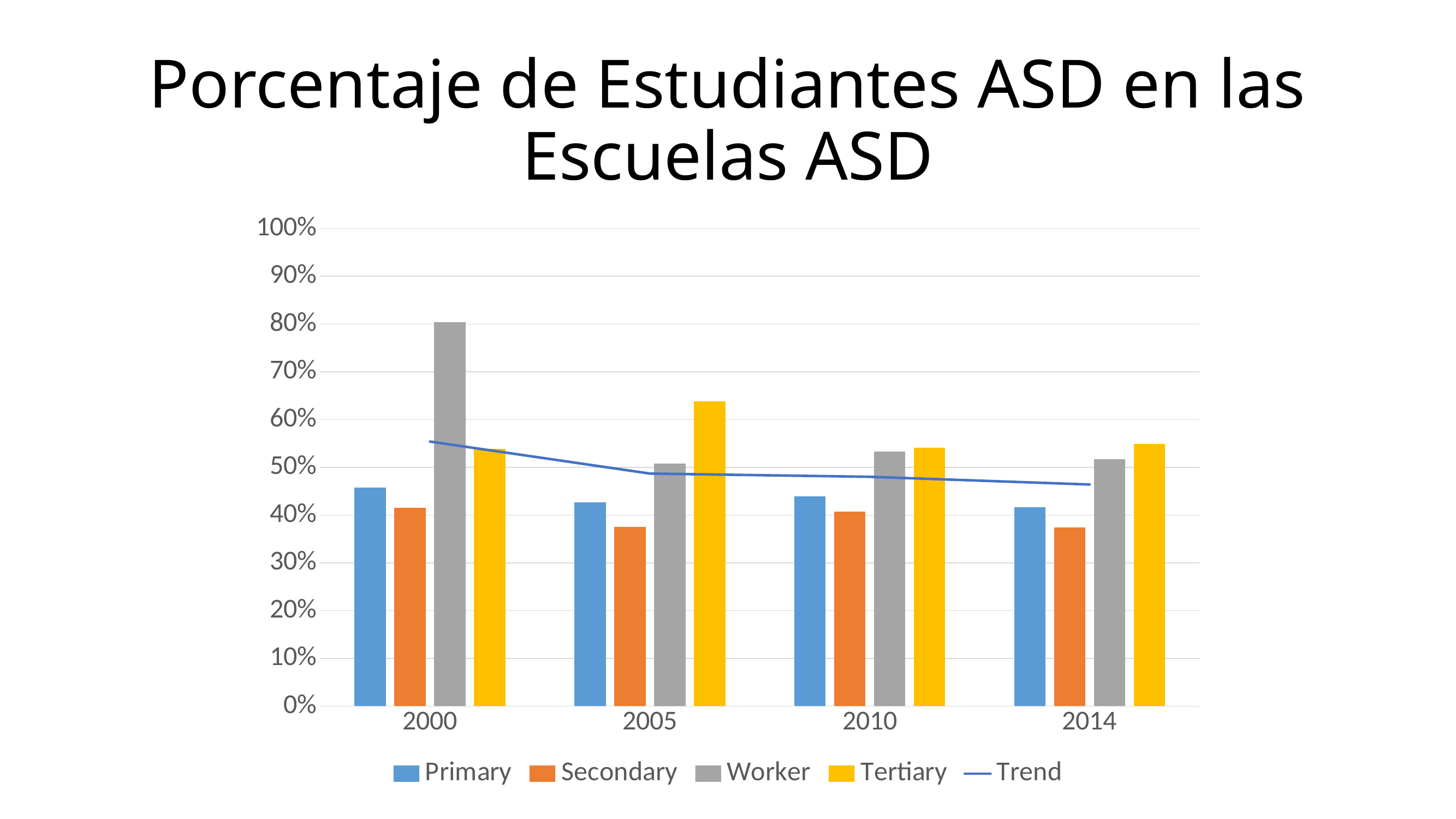
Is the Secondary value for 2005 greater or less than 40%? less In 2005, which is larger: the Tertiary bar or the Worker bar? Tertiary Which is larger: the Primary bar for 2000 or the Primary bar for 2014? 2000 Is the Worker value for 2000 greater or less than 70%? greater Does the Trend line rise or fall from 2000 to 2014? falls Which series has the lowest bar in 2014? Secondary In which year is the Worker bar the highest? 2000 How many series does the legend list? 5 What kind of chart is shown on the slide? Bar chart (with a trend line) What colour represents the Tertiary series? Yellow How many years are shown on the x axis? 4 Is the Tertiary value for 2005 greater or less than 60%? greater